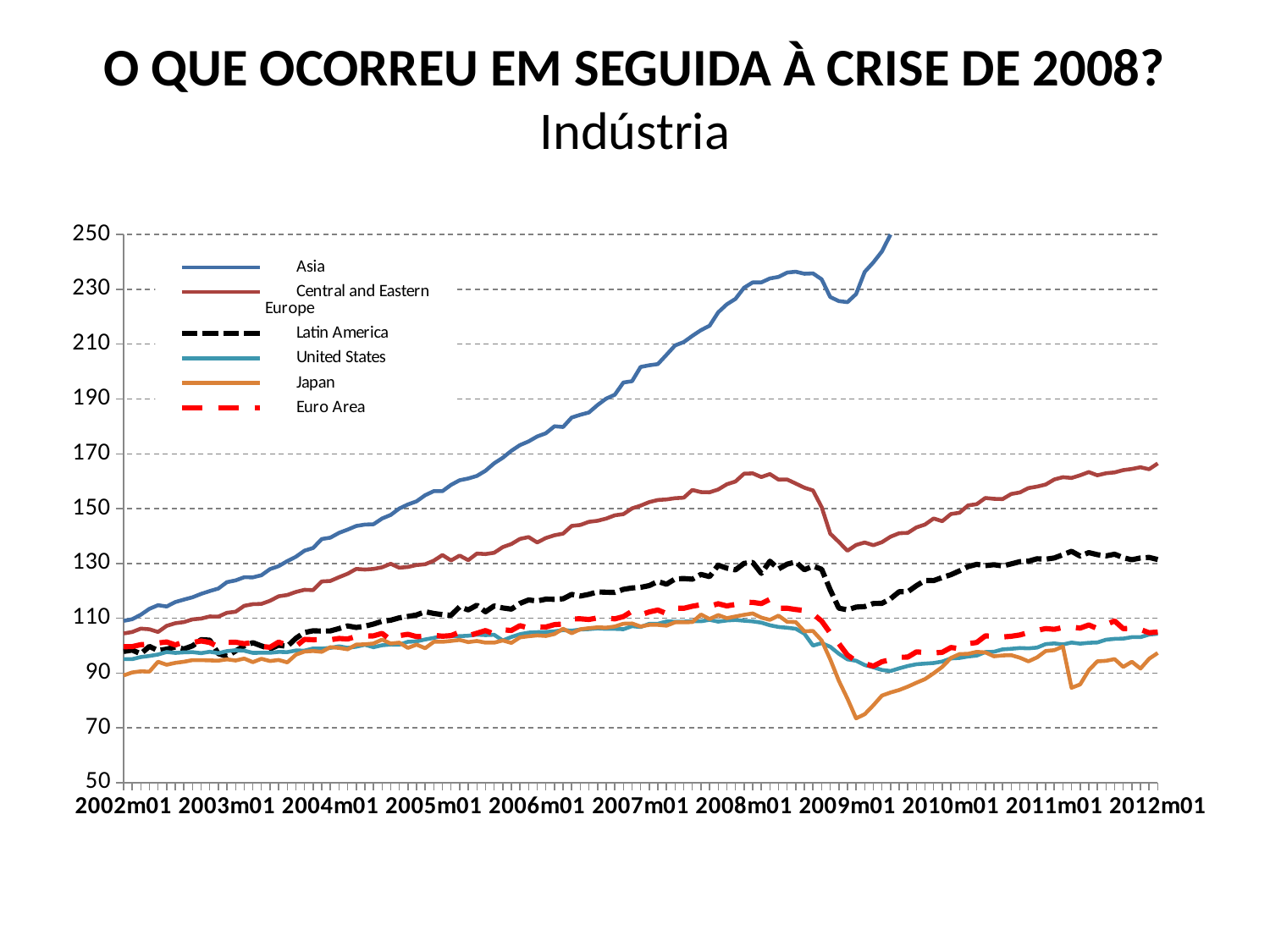
Does the Central and Eastern Europe series rise or fall between 2009m01 and 2012m01? rise What kind of chart is shown on the slide? line chart Which series falls to the lowest value during 2009? Japan How many year labels are shown on the x axis? 11 Is the value for Central and Eastern Europe at 2012m01 greater or less than 150? greater Which series is drawn with a red dashed line? Euro Area How many series does the legend list? 6 Is the value for Japan in early 2009 greater or less than 90? less Which series reaches the highest values on the chart? Asia At 2012m01, which is higher, Latin America or Euro Area? Latin America Which series is drawn with a black dashed line? Latin America Is the value for Asia at 2008m01 greater or less than 210? greater